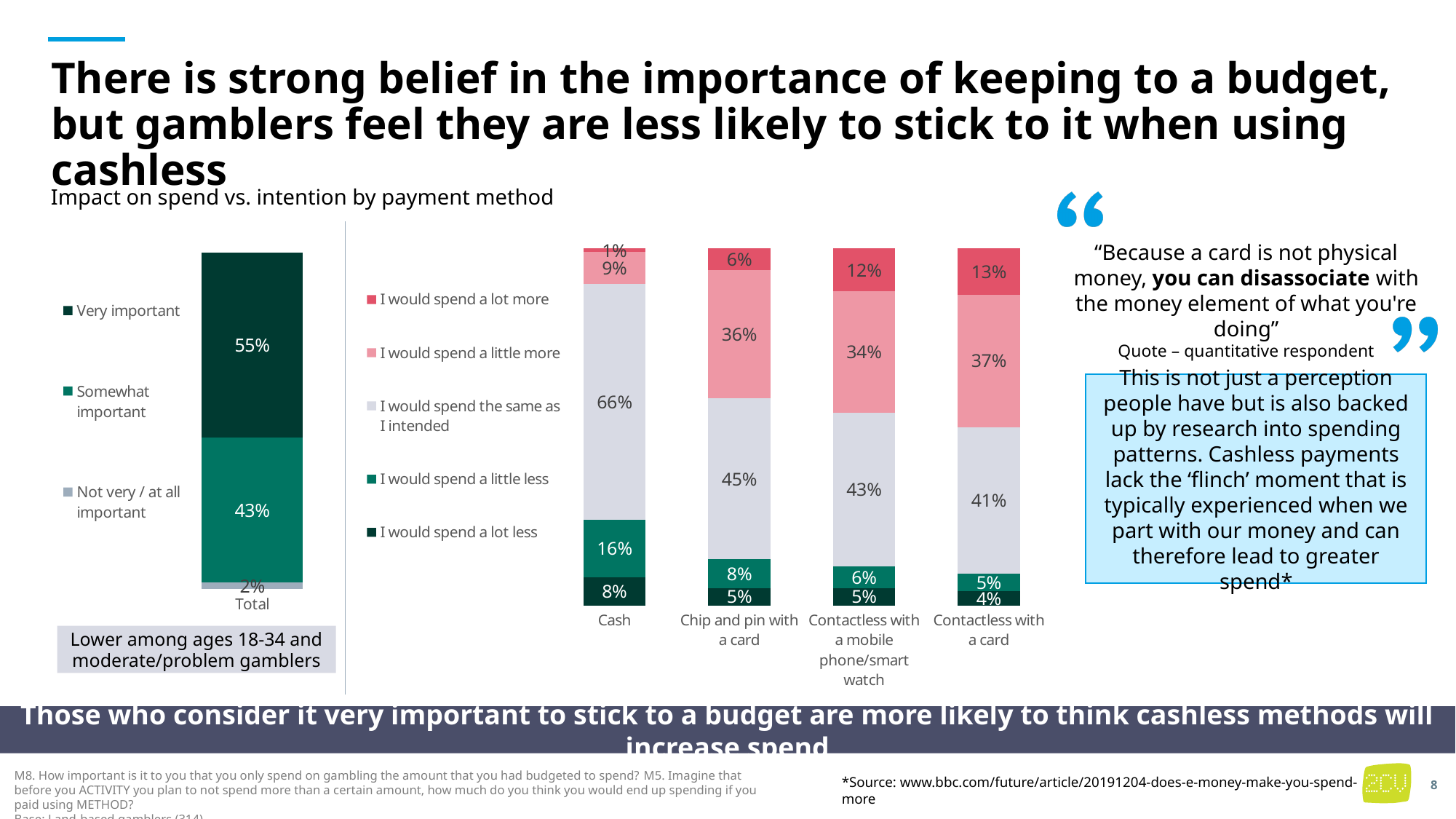
In the right-hand chart, what percentage said they would spend a little more when using chip and pin with a card? 36% In the right-hand chart, is the 'spend a little less' share larger for cash or for chip and pin with a card? Cash What type of chart is used for the impact on spend by payment method? Stacked bar chart In the left-hand chart, what is the difference between the 'very important' and 'somewhat important' shares? 12 percentage points In the right-hand chart, which payment method has the highest share of respondents saying they would spend a lot more? Contactless with a card In the left-hand chart (importance of keeping to a budget), what percentage of the total said it is very important? 55% In the right-hand chart (impact on spend by payment method), what percentage of respondents said they would spend the same as intended when paying with cash? 66% How many payment methods are shown on the x axis of the right-hand chart? 4 In the right-hand chart, what is the difference between the 'spend a little more' share for contactless with a card and for cash? 28 percentage points In the right-hand chart, which payment method has the lowest share of respondents saying they would spend a little more? Cash In the right-hand chart, what percentage said they would spend a lot more when using contactless with a card? 13% How many series does the legend of the right-hand chart list? 5